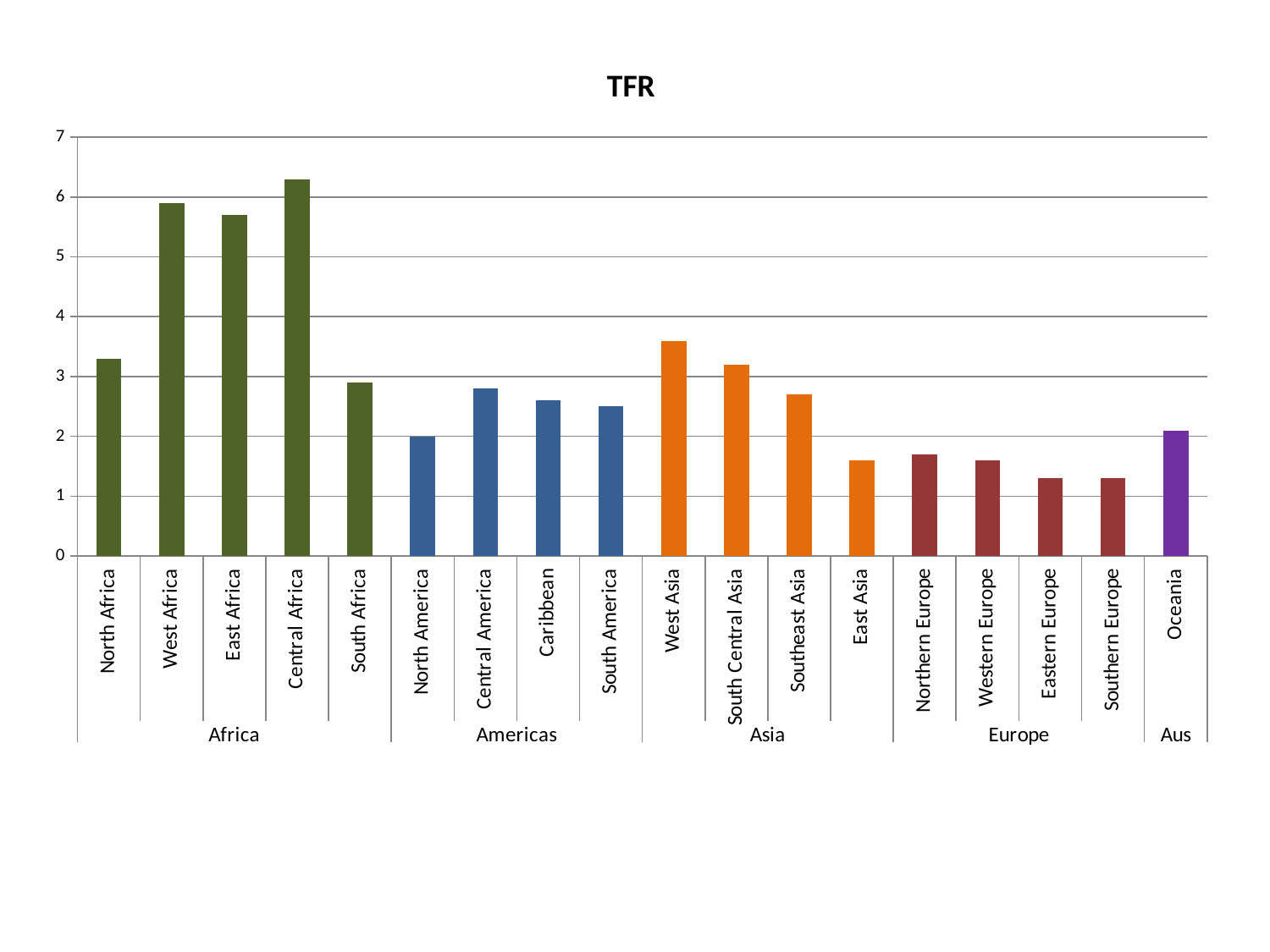
Which category has the highest TFR value? Central Africa How many categories (bars) are plotted in the chart? 18 Which is larger, the value for North Africa or the value for South Africa? North Africa Is the value for West Africa greater or less than 5? greater What kind of chart is shown on the slide? bar chart Which is larger, the value for West Asia or the value for South Central Asia? West Asia What is the title of the chart? TFR Is the value for East Asia greater or less than 2? less What is the TFR value for North America? 2 Among the African regions, which has the lowest TFR value? South Africa Is the value for West Asia greater or less than 3? greater How many continental groups are labelled along the x axis? 5